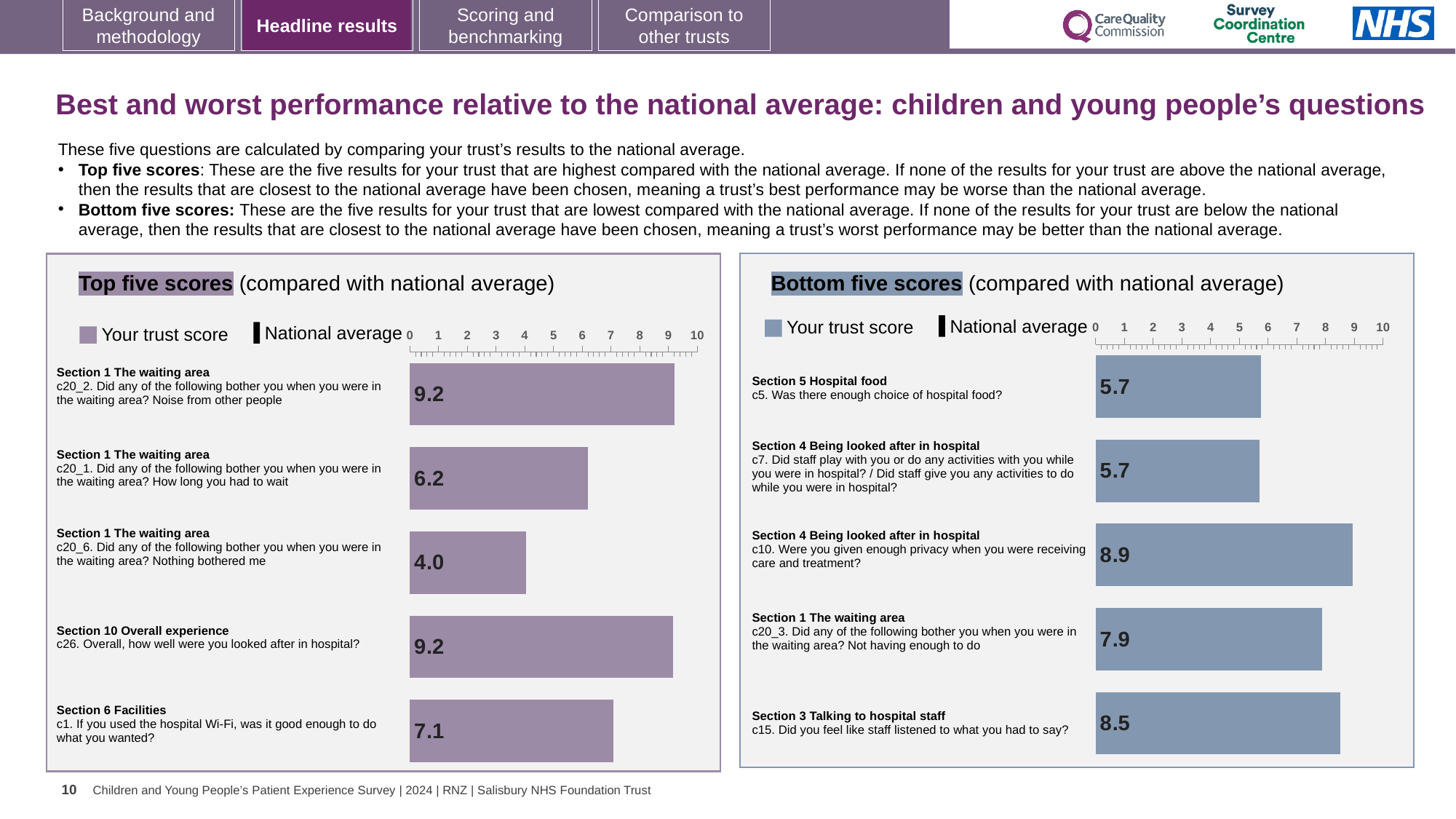
In the Bottom five scores chart, what is the trust score for c10 (enough privacy when receiving care and treatment)? 8.9 In the Bottom five scores chart, what is the trust score for c5 (enough choice of hospital food)? 5.7 How many questions are shown in the Bottom five scores chart? 5 In the Top five scores chart, what is the trust score for c1 (hospital Wi-Fi good enough)? 7.1 In the Top five scores chart, which has the larger trust score: c20_1 (how long you had to wait) or c1 (hospital Wi-Fi)? c1 (hospital Wi-Fi), 7.1 How many series does the legend of the Top five scores chart list? 2 In the Bottom five scores chart, what is the difference between the trust scores for c15 (8.5) and c7 (5.7)? 2.8 What kind of chart is the Bottom five scores chart? Bar chart In the Top five scores chart, what is the difference between the trust scores for c20_2 (9.2) and c20_1 (6.2)? 3.0 In the Top five scores chart, what is the trust score for c20_2 (noise from other people in the waiting area)? 9.2 In the Bottom five scores chart, which question has the highest trust score? c10. Were you given enough privacy when you were receiving care and treatment? (8.9) In the Top five scores chart, which question has the lowest trust score? c20_6. Nothing bothered me (4.0)